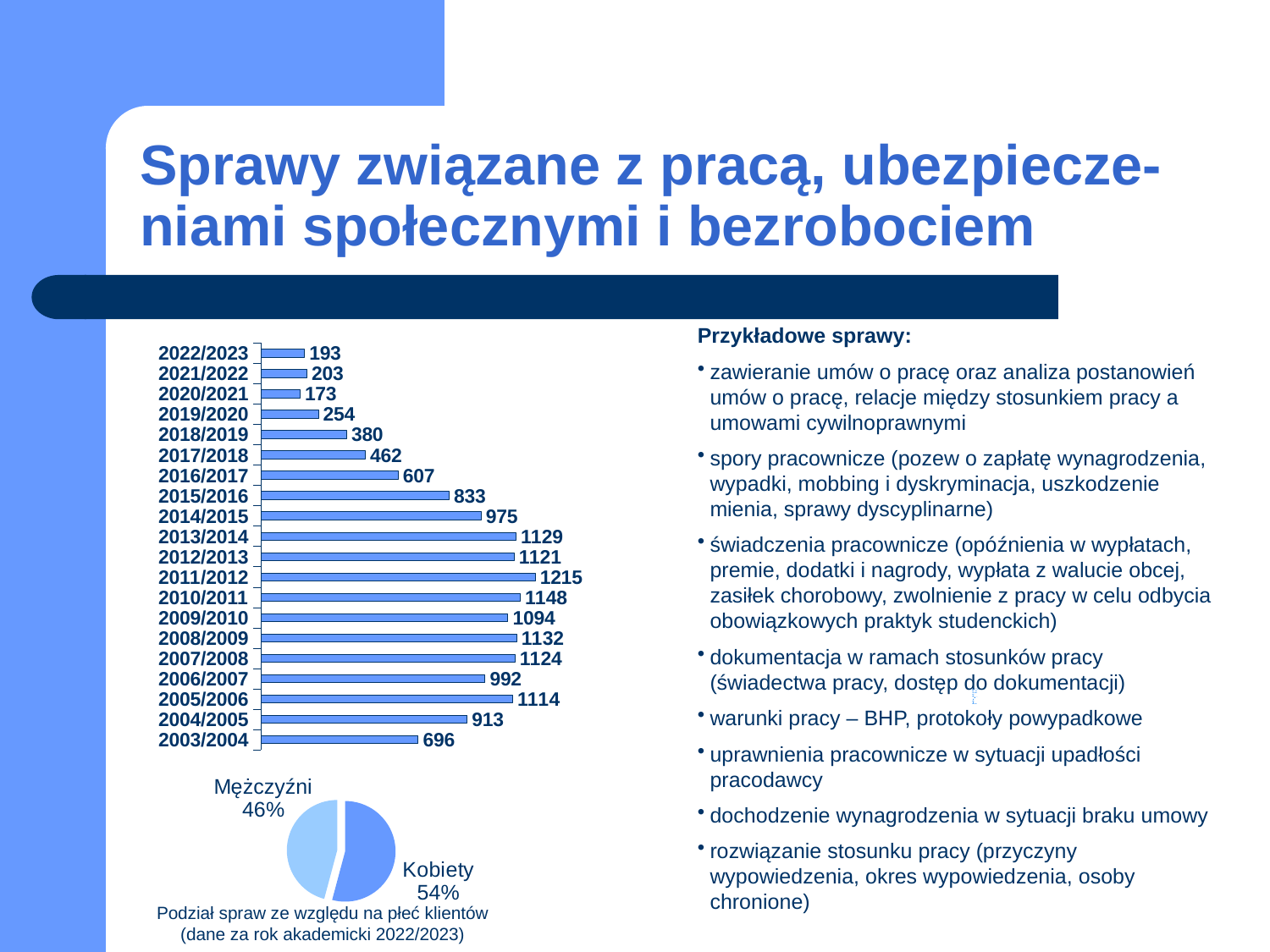
What type of chart is the upper chart on the slide? bar chart In the bar chart, what is the difference between the values for 2016/2017 and 2017/2018? 145 How many academic years are shown in the bar chart? 20 In the bar chart, what is the value for 2011/2012? 1215 In the bar chart, which academic year has the lowest value? 2020/2021 In the pie chart, which group has the larger share: Mężczyźni or Kobiety? Kobiety In the pie chart, what share of cases is for Kobiety? 54% In the bar chart, do the values rise or fall from 2016/2017 to 2022/2023? fall In the bar chart, what is the value for 2022/2023? 193 In the bar chart, what is the value for 2003/2004? 696 In the bar chart, which academic year has the highest value? 2011/2012 In the bar chart, which is larger: the value for 2014/2015 or the value for 2006/2007? 2006/2007